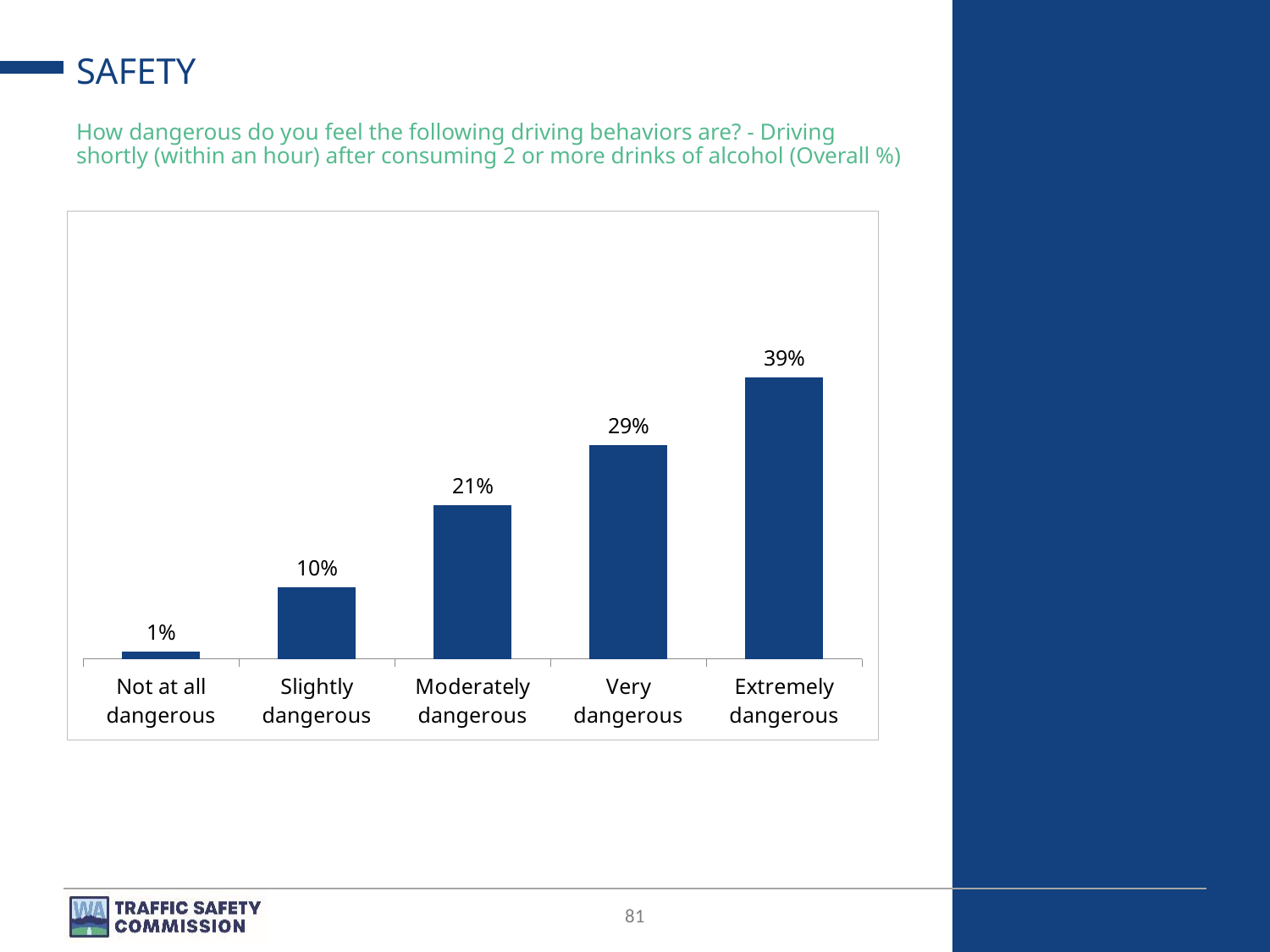
Which is larger, the value for 'Very dangerous' or the value for 'Moderately dangerous'? Very dangerous How many categories are shown on the x axis? 5 Which category has the lowest value? Not at all dangerous Do the values rise or fall moving from left to right along the x axis? Rise What kind of chart is shown on the slide? Bar chart What percentage of respondents rated driving shortly after consuming 2 or more drinks as 'Extremely dangerous'? 39% What is the value shown for 'Slightly dangerous'? 10% Which category has the highest value? Extremely dangerous What is the value shown for 'Not at all dangerous'? 1% What is the difference between the 'Moderately dangerous' and 'Slightly dangerous' values? 11% What is the value shown for 'Moderately dangerous'? 21% What is the difference between the 'Extremely dangerous' and 'Very dangerous' values? 10%